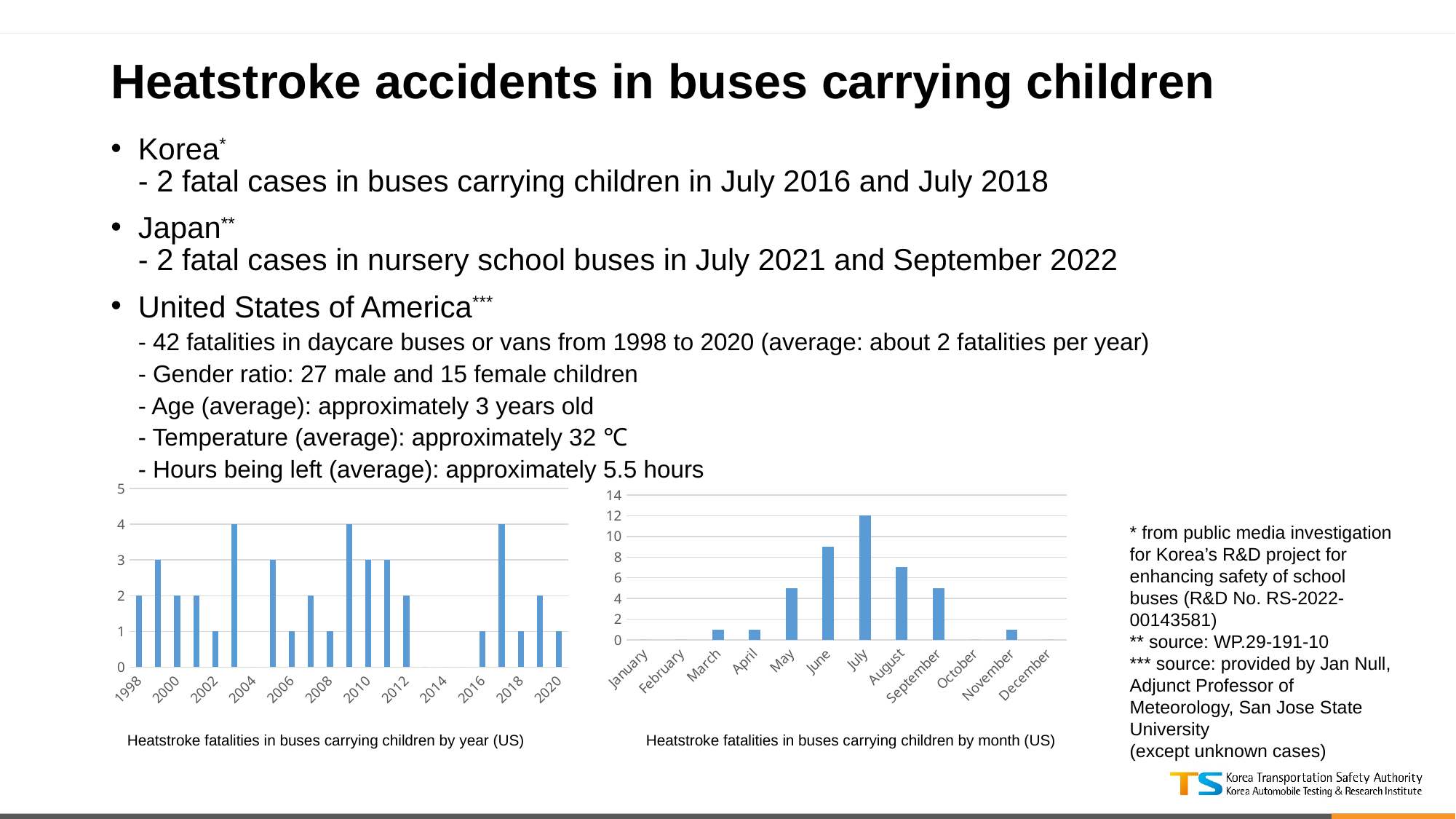
In the chart 'Heatstroke fatalities in buses carrying children by year (US)', what is the difference between the values for 2003 and 2002? 3 In the chart 'Heatstroke fatalities in buses carrying children by month (US)', which month has the highest value? July In the chart 'Heatstroke fatalities in buses carrying children by year (US)', what is the value for 2003? 4 In the chart 'Heatstroke fatalities in buses carrying children by year (US)', what is the value for 1999? 3 What kind of chart is 'Heatstroke fatalities in buses carrying children by month (US)'? bar chart How many months are shown on the x axis of the chart 'Heatstroke fatalities in buses carrying children by month (US)'? 12 In the chart 'Heatstroke fatalities in buses carrying children by year (US)', which is larger, the value for 2009 or the value for 2008? 2009 What is the highest value shown on the y axis of the chart 'Heatstroke fatalities in buses carrying children by year (US)'? 5 In the chart 'Heatstroke fatalities in buses carrying children by month (US)', is the value for June greater or less than 8? greater In the chart 'Heatstroke fatalities in buses carrying children by month (US)', what is the value for July? 12 In the chart 'Heatstroke fatalities in buses carrying children by month (US)', which is larger, the value for June or the value for September? June In the chart 'Heatstroke fatalities in buses carrying children by month (US)', is the value for August greater or less than 8? less